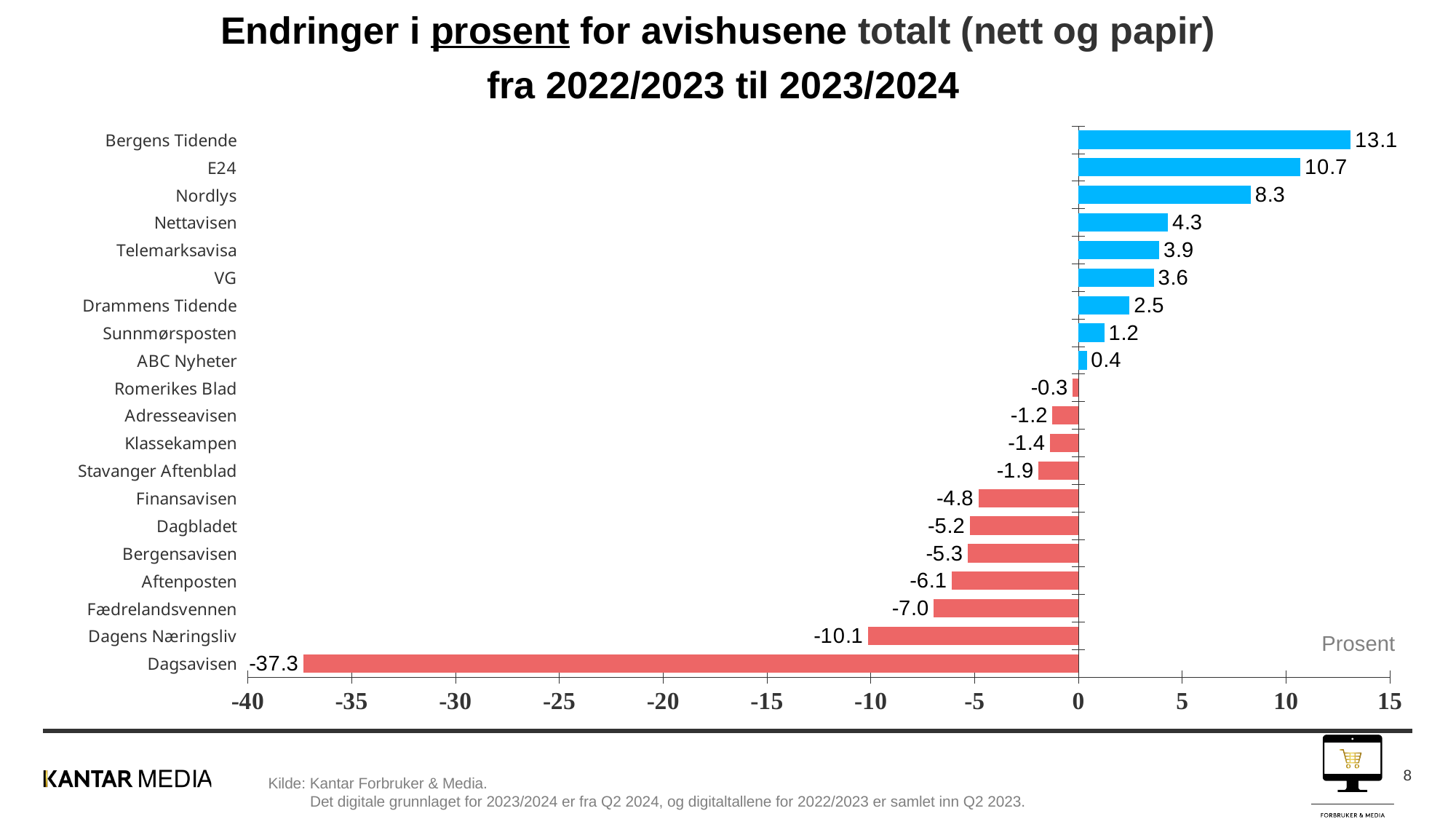
What is the value shown for Aftenposten? -6.1 What kind of chart is shown on the slide? bar chart Which has a larger value, Nettavisen or Telemarksavisa? Nettavisen Is the value for Dagsavisen greater or less than -35? less What is the difference between the values for E24 and Nordlys? 2.4 What is the value shown for VG? 3.6 How many newspapers are shown in the chart? 20 Which newspaper has the highest percentage change? Bergens Tidende What is the percentage change shown for Bergens Tidende? 13.1 What colour are the bars with negative values? red Which newspaper has the lowest percentage change? Dagsavisen What is the value shown for Dagens Næringsliv? -10.1